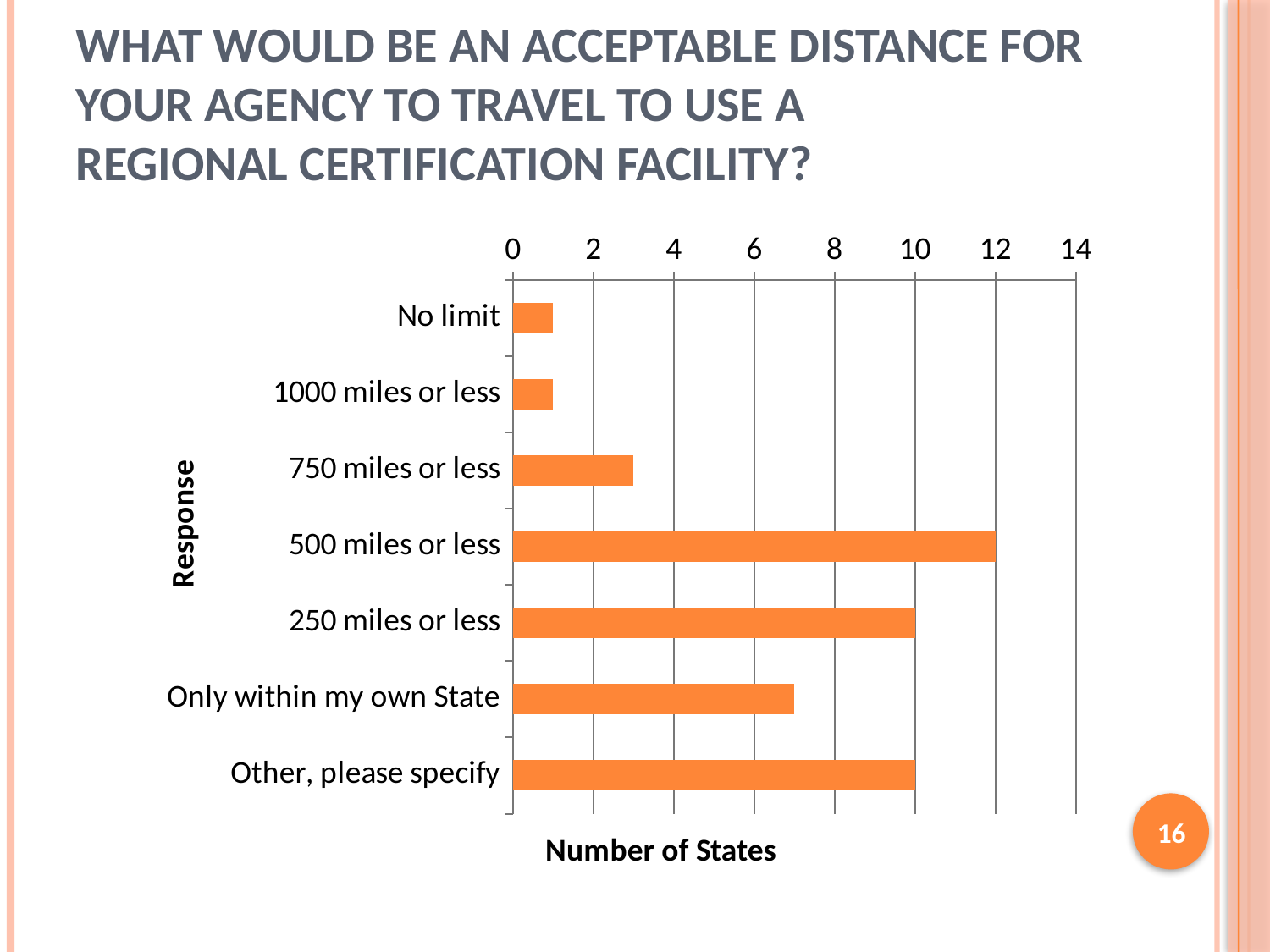
What is the number of states for "250 miles or less"? 10 Which has more states: "500 miles or less" or "Only within my own State"? 500 miles or less What is the difference in number of states between "500 miles or less" and "250 miles or less"? 2 Which response has the highest number of states? 500 miles or less Is the value for "No limit" greater or less than 2? less What is the number of states for "Other, please specify"? 10 What type of chart is shown on the slide? bar chart Is the value for "750 miles or less" greater or less than 4? less How many response categories are shown in the chart? 7 What is the number of states for "500 miles or less"? 12 What is the title of the horizontal axis of the chart? Number of States Is the value for "Only within my own State" greater or less than 6? greater